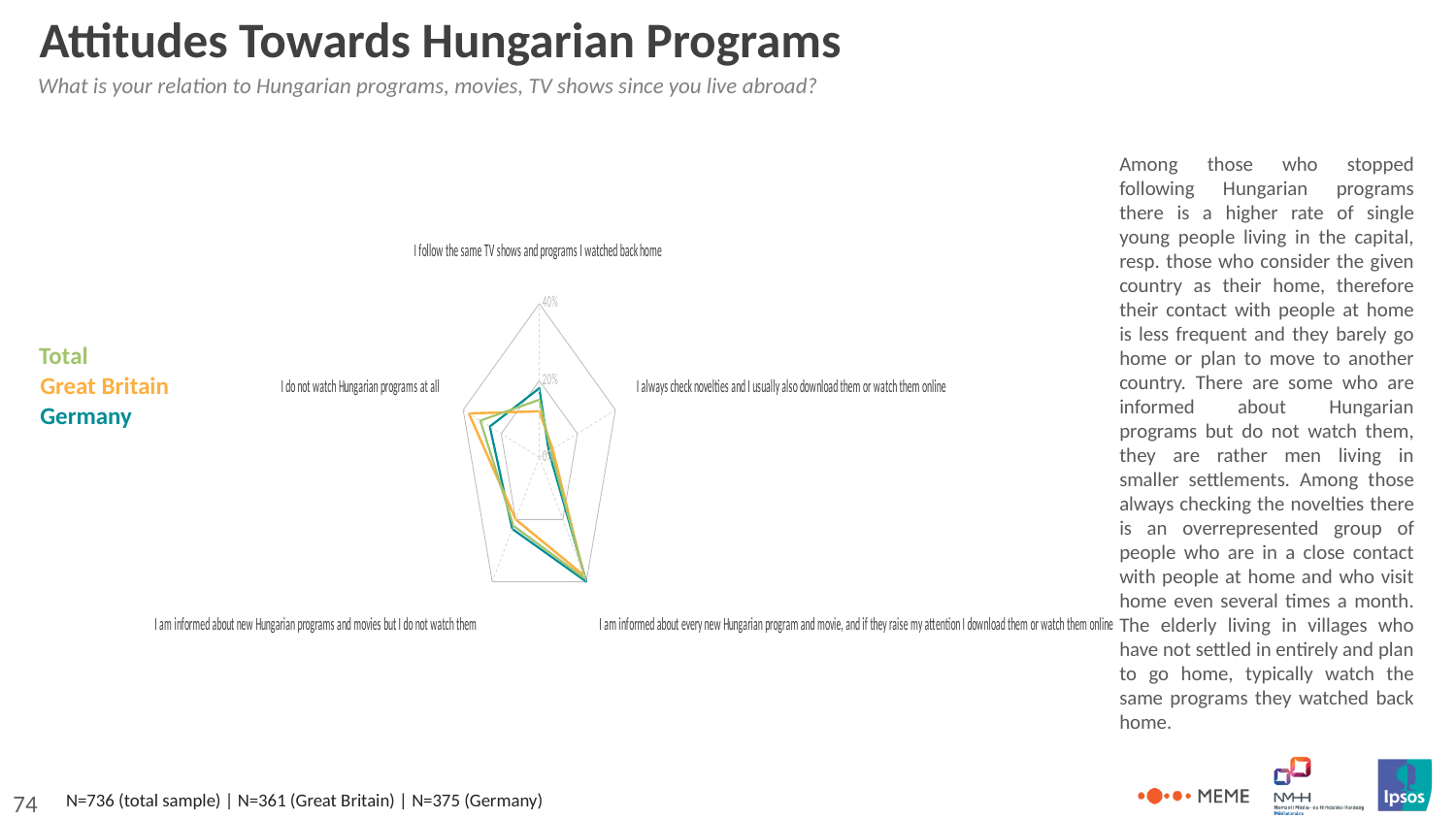
Which series are listed in the chart's legend? Total, Great Britain, Germany How many series does the chart's legend list? 3 How many categories (attitude statements) does the radar chart plot? 5 What kind of chart is shown on the slide? Radar chart Which category has the highest values across all series in the radar chart? I am informed about every new Hungarian program and movie, and if they raise my attention I download them or watch them online Is the value for "I always check novelties and I usually also download them or watch them online" greater or less than 20%? less Is the value for "I am informed about every new Hungarian program and movie, and if they raise my attention I download them or watch them online" greater or less than 20%? greater What is the highest percentage tick shown on the radar chart's axis? 40% Which is larger: the value for "I am informed about every new Hungarian program and movie, and if they raise my attention I download them or watch them online" or the value for "I always check novelties and I usually also download them or watch them online"? I am informed about every new Hungarian program and movie, and if they raise my attention I download them or watch them online